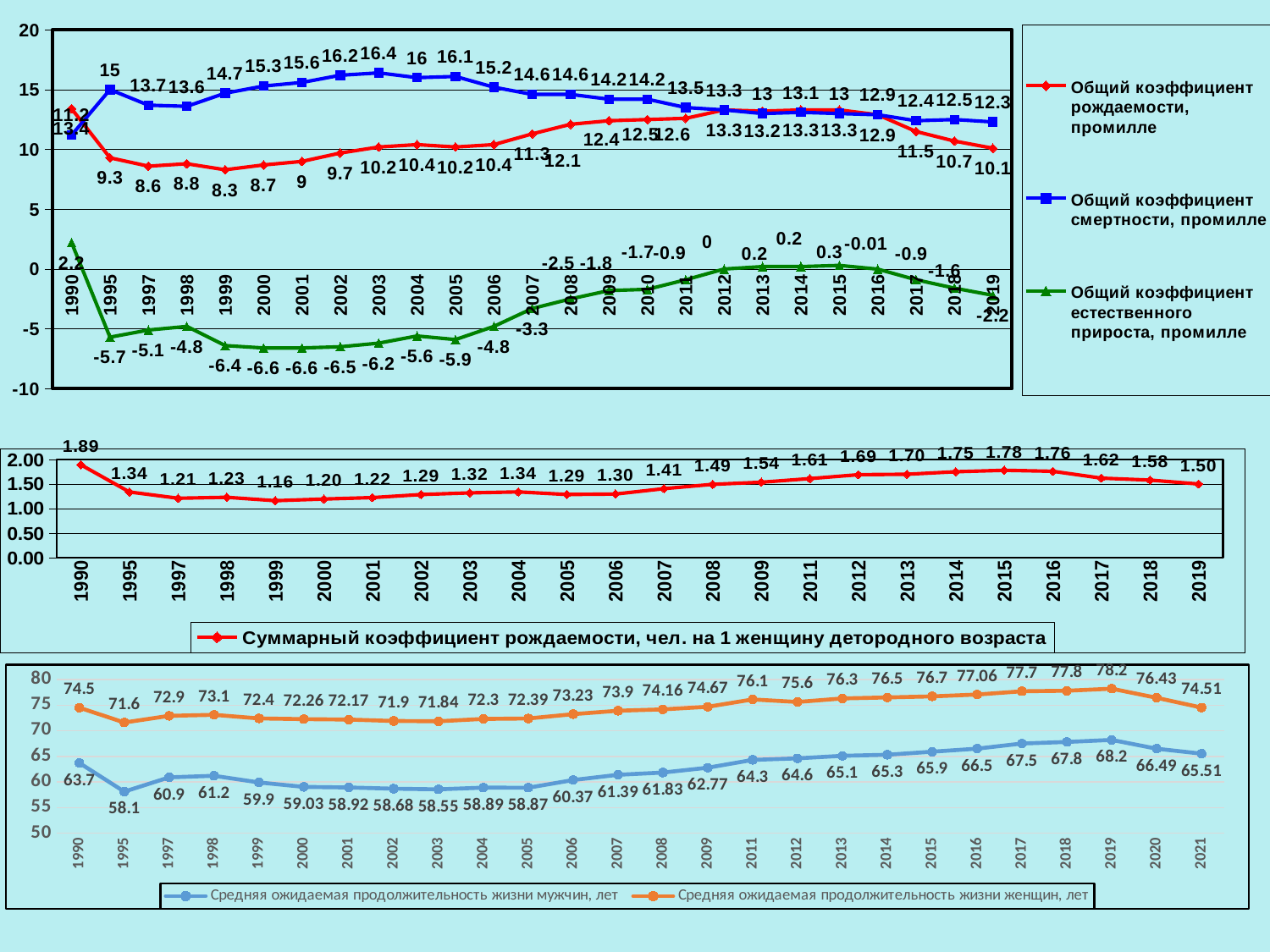
In the middle chart, how many years are plotted on the x axis? 24 What type of chart is the bottom chart? Line chart In the bottom chart, what is the difference between women's and men's life expectancy in 2021? 9 In the middle chart, what is the total fertility rate (Суммарный коэффициент рождаемости) in 2015? 1.78 In the bottom chart, in which year is men's life expectancy lowest? 1995 In the top chart, in which year is the natural increase (Общий коэффициент естественного прироста) lowest? 2000 and 2001 (-6.6) In the top chart, what is the value of the death rate (Общий коэффициент смертности) in 2003? 16.4 In the bottom chart, what is the life expectancy of men (Средняя ожидаемая продолжительность жизни мужчин) in 2019? 68.2 In the top chart, what is the value of the birth rate (Общий коэффициент рождаемости) in 1999? 8.3 In the top chart, how many series does the legend list? 3 In the middle chart, in which year is the total fertility rate highest? 1990 In the top chart, what is the difference between the death rate and the birth rate in 1995? 5.7